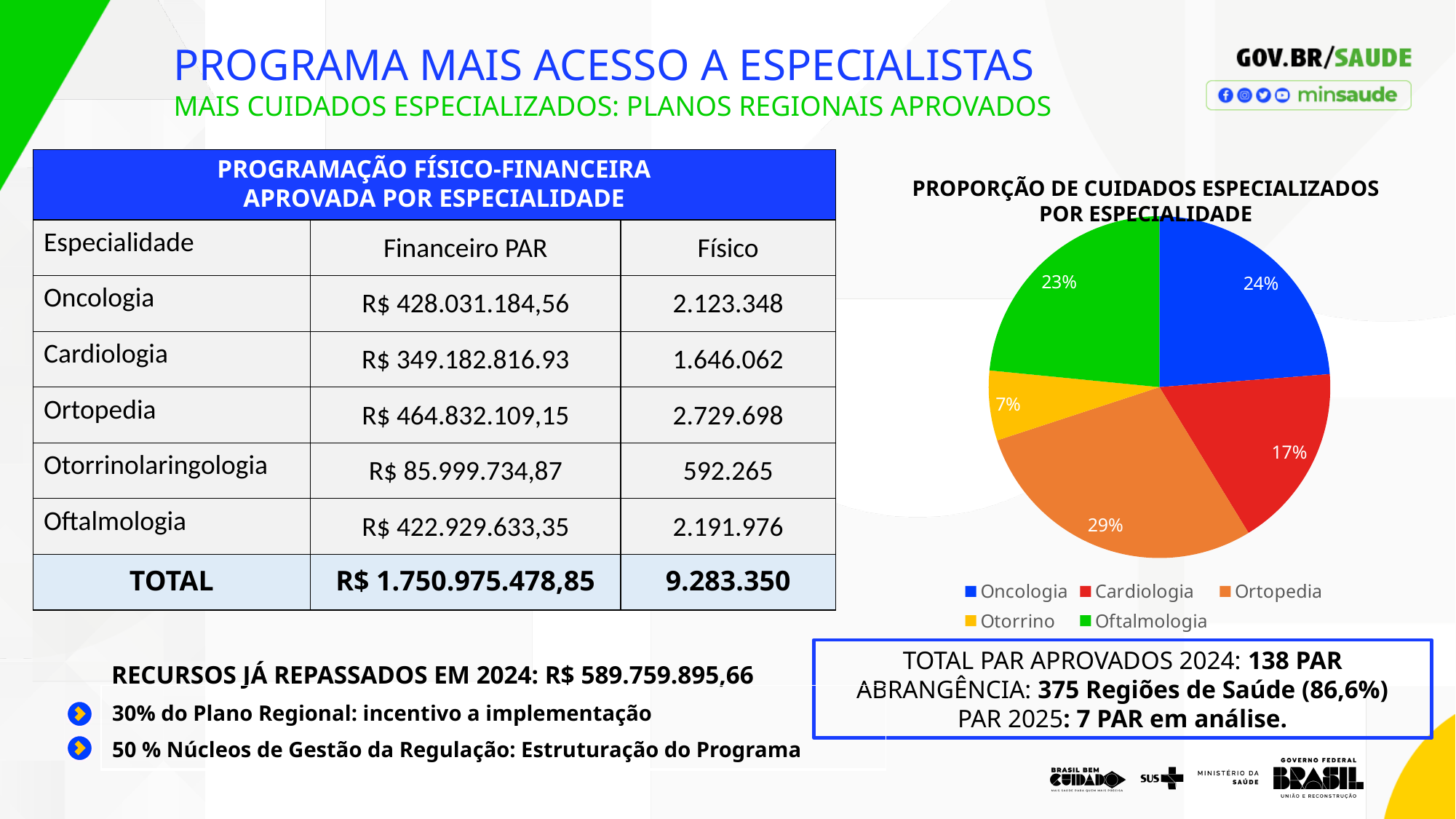
What is the title of the pie chart? PROPORÇÃO DE CUIDADOS ESPECIALIZADOS POR ESPECIALIDADE What share of the pie chart does Oftalmologia represent? 23% What is the difference in percentage points between the Ortopedia and Cardiologia slices? 12 What share of the pie chart does Cardiologia represent? 17% What kind of chart is shown on the slide? Pie chart What share of the pie chart does Oncologia represent? 24% How many slices does the pie chart have? 5 Which specialty has the smallest slice in the pie chart? Otorrino Which specialty has the largest slice in the pie chart? Ortopedia Which slice is larger in the pie chart, Oncologia or Cardiologia? Oncologia